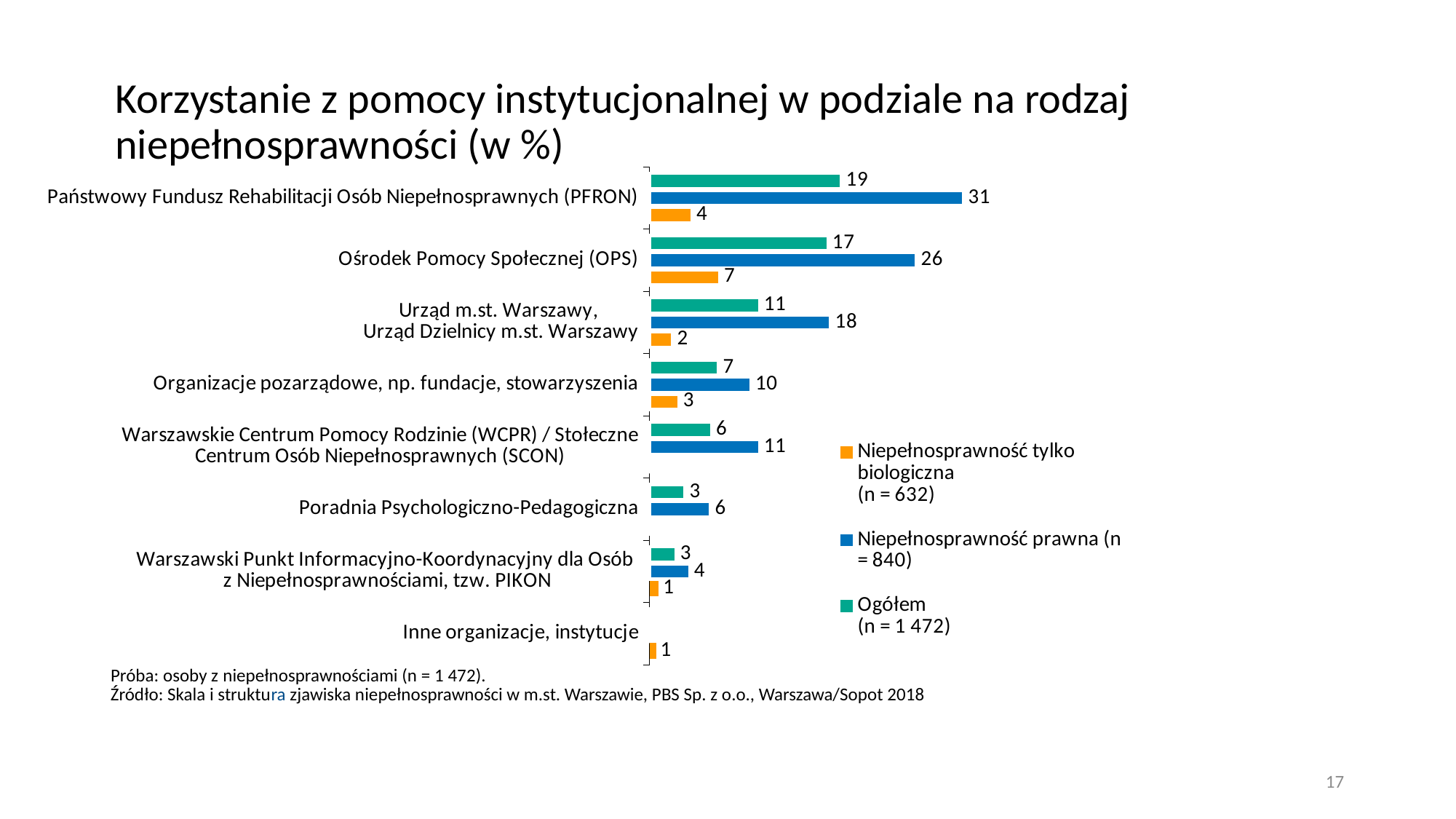
For Organizacje pozarządowe, np. fundacje, stowarzyszenia, which is larger: the Niepełnosprawność prawna value or the Ogółem value? Niepełnosprawność prawna What is the Ogółem value for Ośrodek Pomocy Społecznej (OPS)? 17 How many categories are shown on the chart? 8 What is the Niepełnosprawność prawna value for Warszawskie Centrum Pomocy Rodzinie (WCPR) / Stołeczne Centrum Osób Niepełnosprawnych (SCON)? 11 What is the value for Niepełnosprawność prawna for Państwowy Fundusz Rehabilitacji Osób Niepełnosprawnych (PFRON)? 31 How many series does the legend list? 3 Which category has the highest Ogółem value? Państwowy Fundusz Rehabilitacji Osób Niepełnosprawnych (PFRON) Which category has the lowest Niepełnosprawność prawna value among those with a blue bar? Warszawski Punkt Informacyjno-Koordynacyjny dla Osób z Niepełnosprawnościami, tzw. PIKON What is the value for Niepełnosprawność tylko biologiczna for Urząd m.st. Warszawy, Urząd Dzielnicy m.st. Warszawy? 2 What is the difference between the Niepełnosprawność prawna and Ogółem values for Ośrodek Pomocy Społecznej (OPS)? 9 What type of chart is shown on the slide? bar chart What sample size is given in the legend for Ogółem? n = 1 472